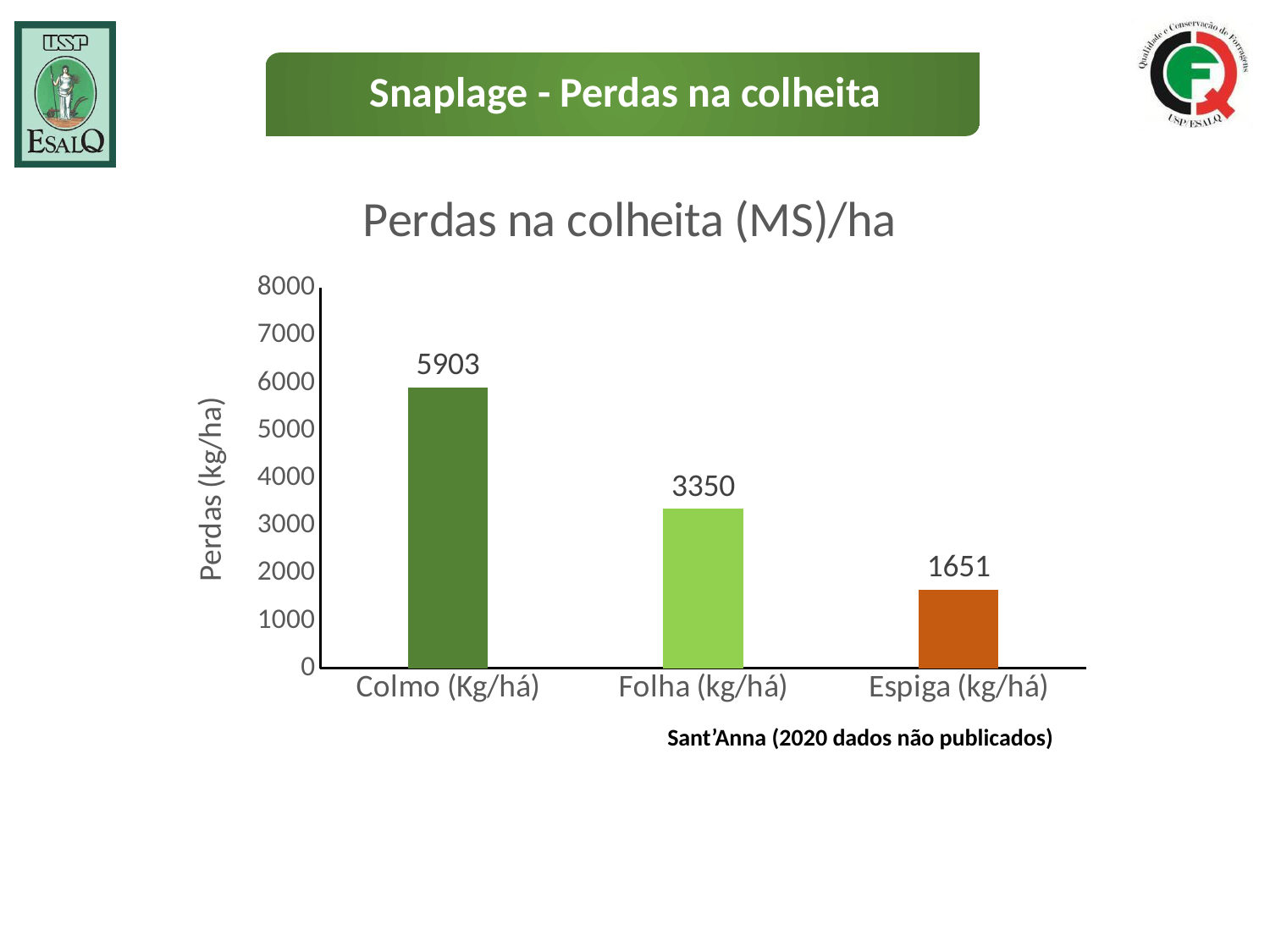
Is the value for Colmo (Kg/há) greater or less than 5000? greater What is the value for Folha (kg/há)? 3350 Which category has the highest value? Colmo (Kg/há) What is the difference between the values for Colmo (Kg/há) and Folha (kg/há)? 2553 Which is larger, the value for Folha (kg/há) or the value for Espiga (kg/há)? Folha (kg/há) What is the value for Colmo (Kg/há)? 5903 What is the value for Espiga (kg/há)? 1651 Which category has the lowest value? Espiga (kg/há) How many categories are shown on the x axis? 3 What is the difference between the values for Folha (kg/há) and Espiga (kg/há)? 1699 What is the title of the chart? Perdas na colheita (MS)/ha What kind of chart is shown on the slide? bar chart